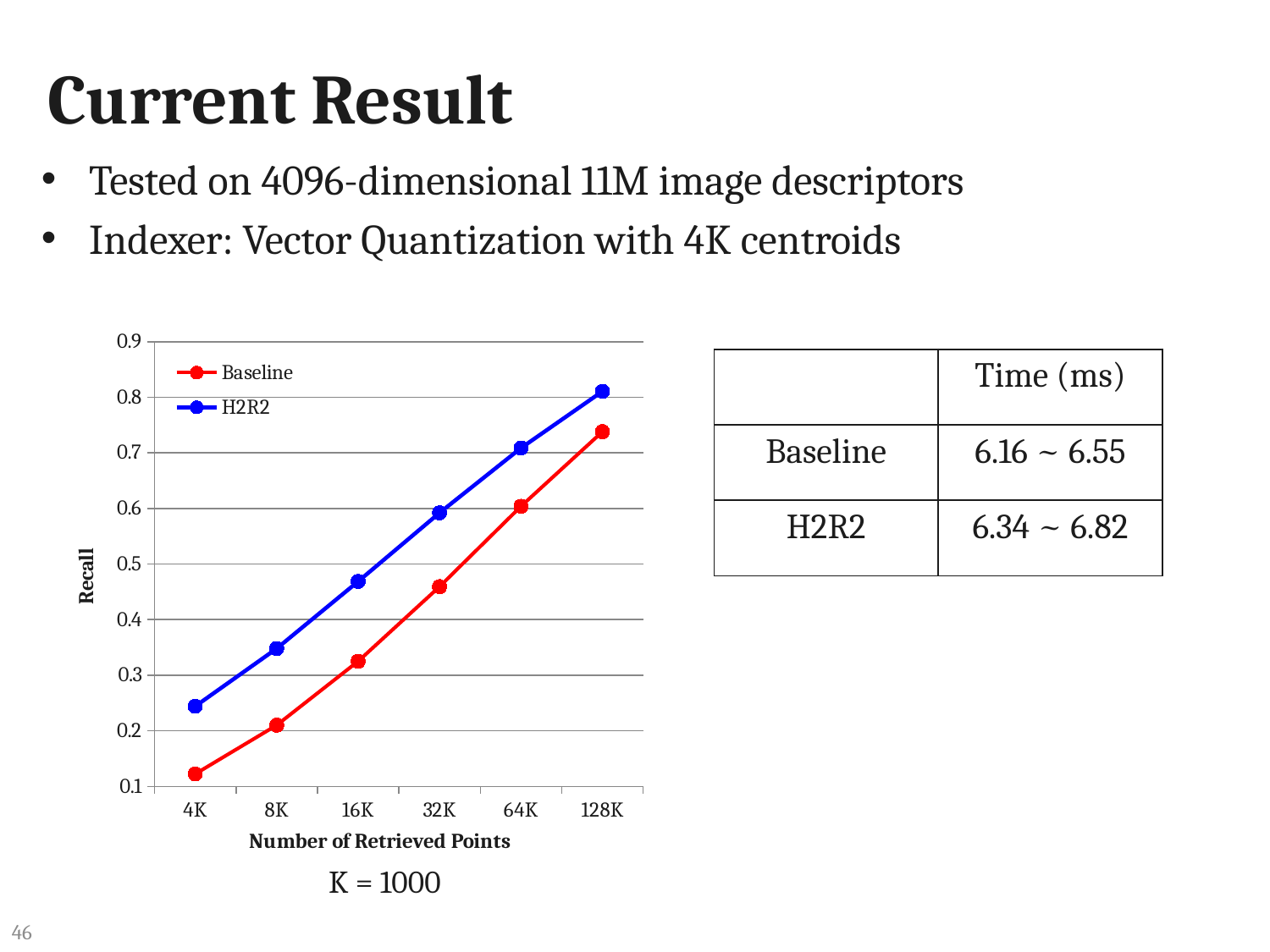
Is the recall for Baseline at 4K retrieved points greater or less than 0.2? less Does the recall for Baseline rise or fall as the number of retrieved points increases from 4K to 128K? rise Which colour is used for the H2R2 line in the chart? blue How many points along the x axis does each line in the chart have? 6 What is the label of the chart's y axis? Recall Is the recall for Baseline at 128K retrieved points greater or less than 0.7? greater At 32K retrieved points, which series has the higher recall, Baseline or H2R2? H2R2 At which number of retrieved points is the Baseline recall lowest? 4K What kind of chart is shown on the slide? line chart Is the recall for H2R2 at 16K retrieved points greater or less than 0.5? less How many series does the chart's legend list? 2 At which number of retrieved points does H2R2 reach its highest recall? 128K